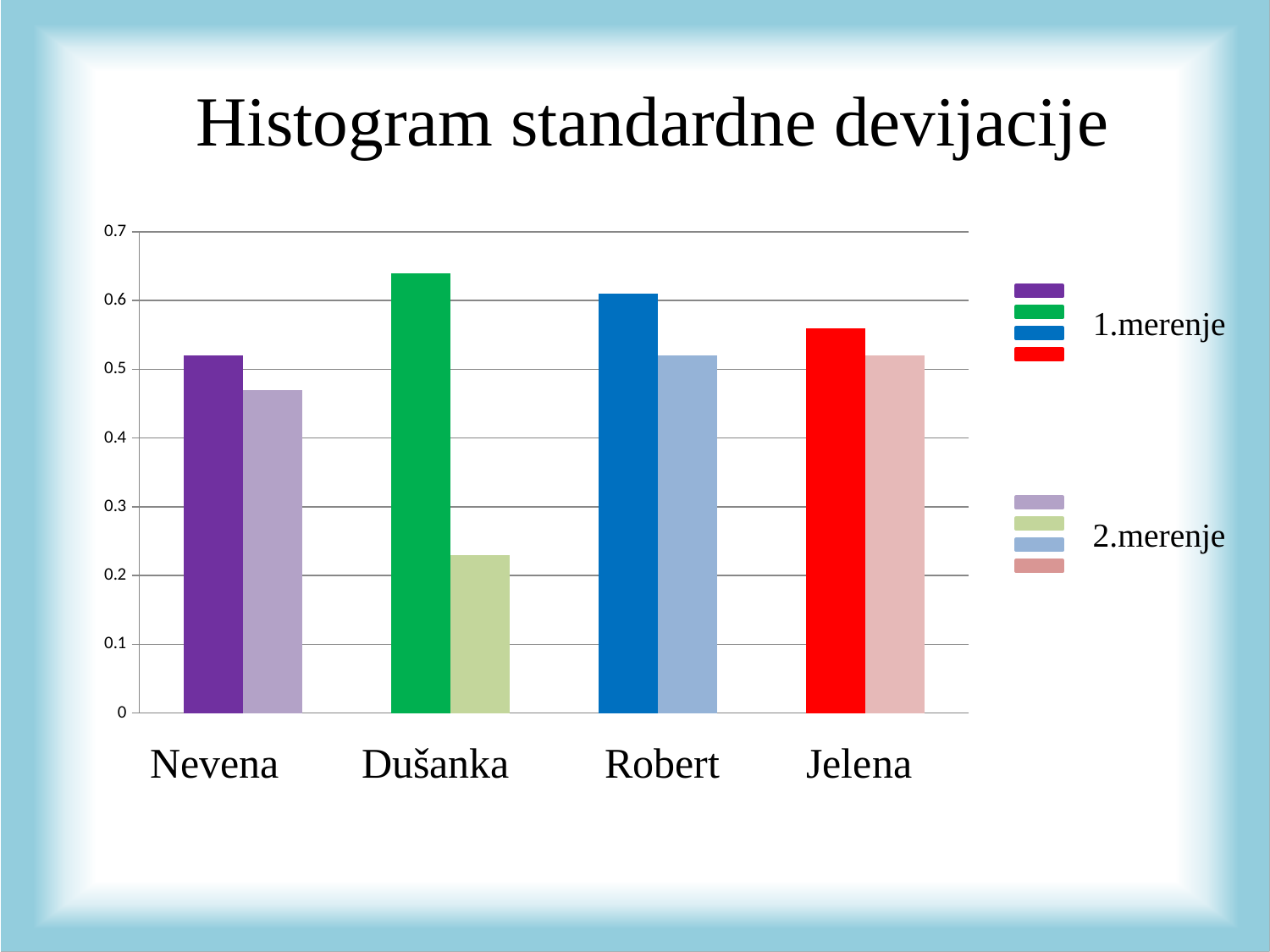
Which is larger: the 1.merenje value for Dušanka or the 1.merenje value for Jelena? Dušanka For Dušanka, which is larger: the 1.merenje value or the 2.merenje value? 1.merenje What kind of chart is shown on the slide? bar chart Which person has the lowest 2.merenje value? Dušanka Is the 2.merenje value for Nevena greater or less than 0.5? less Which person has the highest 1.merenje value? Dušanka Is the 2.merenje value for Dušanka greater or less than 0.3? less What is the title of the chart? Histogram standardne devijacije Which person has the lowest 1.merenje value? Nevena How many people (categories) are shown on the x axis? 4 How many measurement series does the legend list? 2